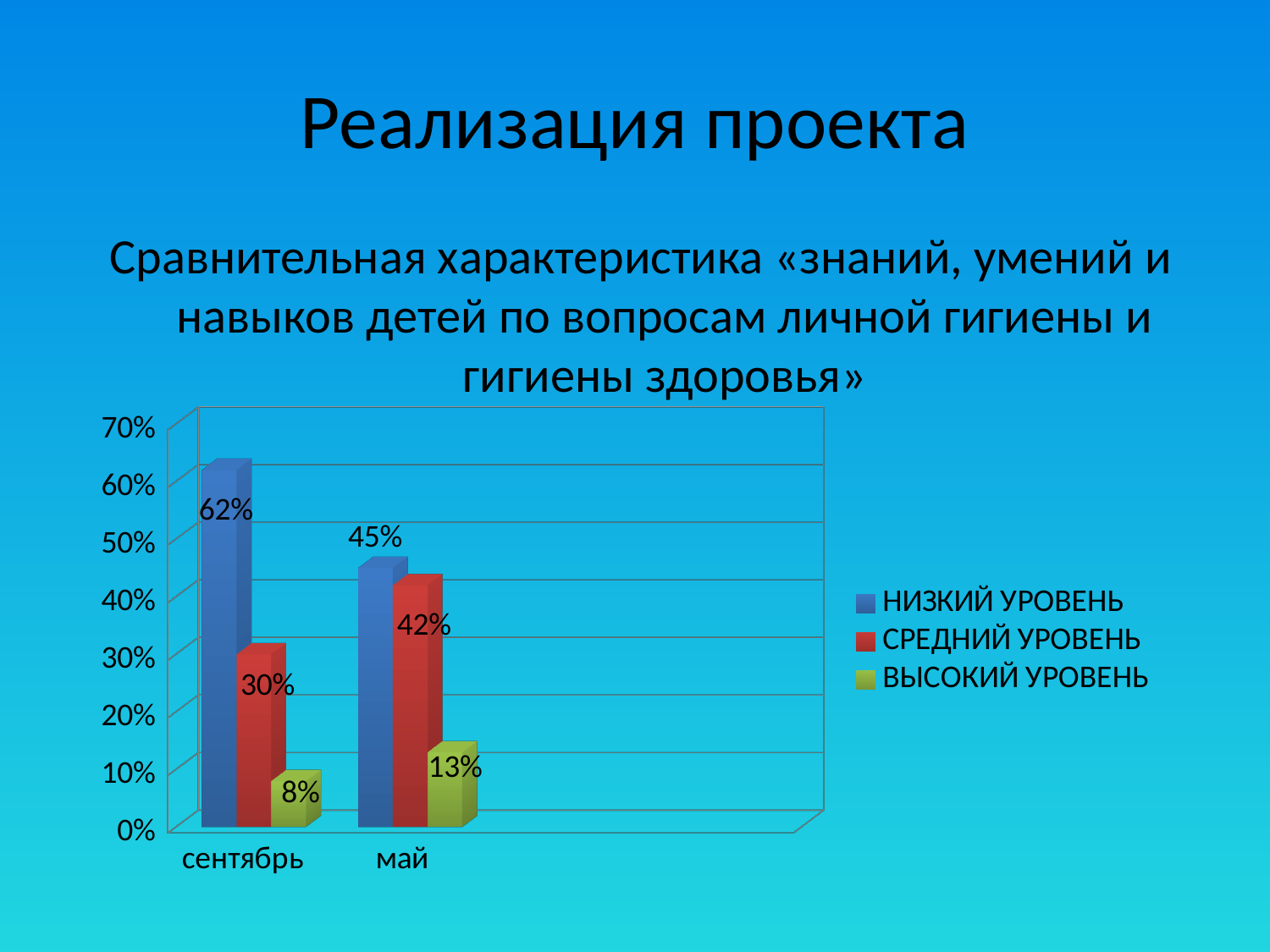
What is the value for ВЫСОКИЙ УРОВЕНЬ in сентябрь? 8% How many series does the legend list? 3 What is the value for ВЫСОКИЙ УРОВЕНЬ in май? 13% How many categories are shown on the x axis? 2 What is the value for СРЕДНИЙ УРОВЕНЬ in май? 42% What kind of chart is shown on the slide? bar chart Does the value for ВЫСОКИЙ УРОВЕНЬ rise or fall from сентябрь to май? rise Which series has the lowest value in май? ВЫСОКИЙ УРОВЕНЬ What is the value for НИЗКИЙ УРОВЕНЬ in сентябрь? 62% Which is larger: СРЕДНИЙ УРОВЕНЬ in сентябрь or СРЕДНИЙ УРОВЕНЬ in май? май What is the difference between the НИЗКИЙ УРОВЕНЬ values for сентябрь and май? 17% Which series has the highest value in сентябрь? НИЗКИЙ УРОВЕНЬ